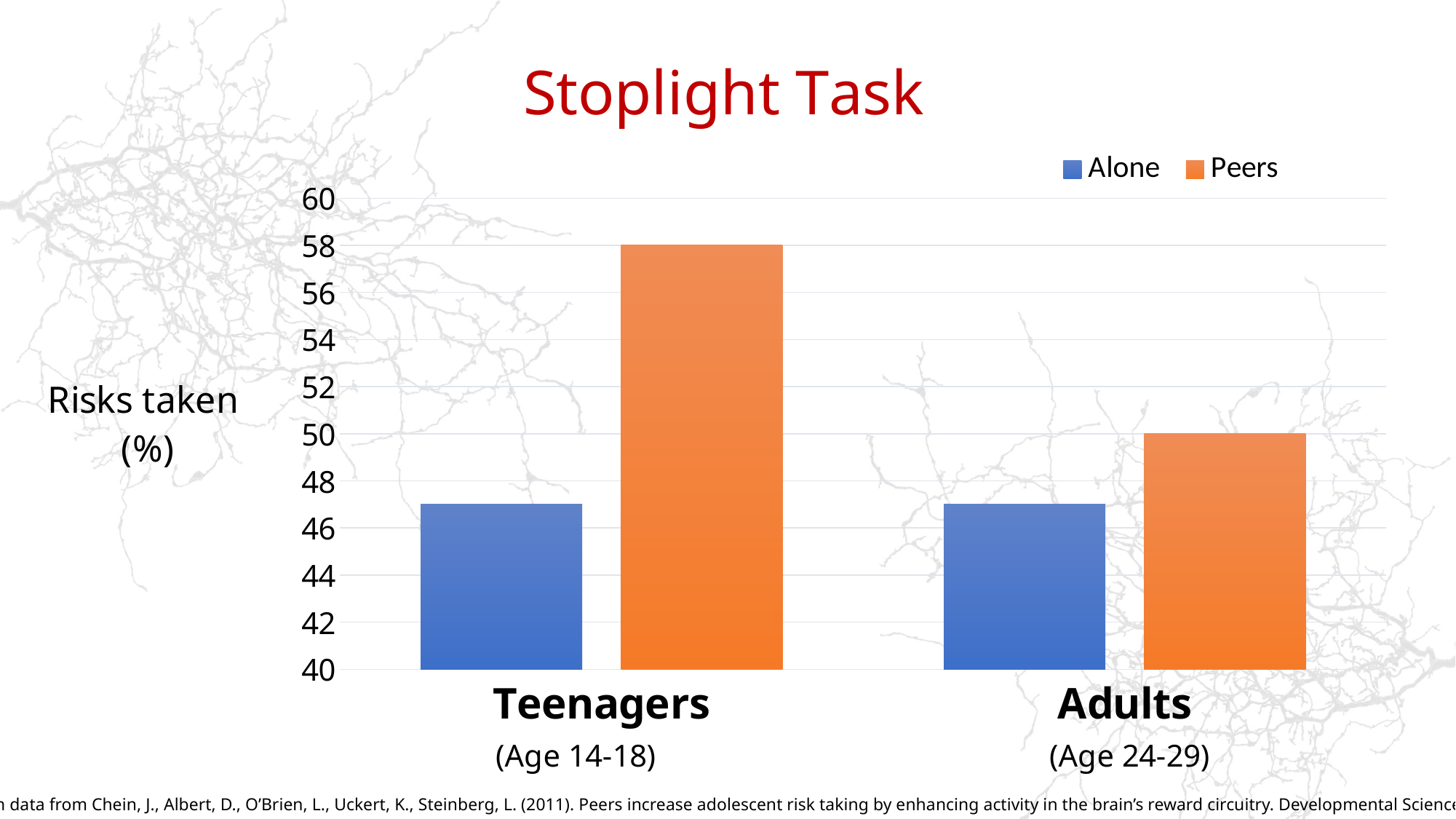
For Teenagers, which is larger: the Alone value or the Peers value? Peers Which group and condition has the highest bar on the chart? Teenagers, Peers How many age groups are shown on the x axis? 2 What kind of chart is shown on the slide? Bar chart Is the Alone value for Adults greater or less than 46? greater What is the difference between the Peers value for Teenagers and the Peers value for Adults? 8 What is the value for Peers in the Teenagers group? 58 Which group has the larger Peers value, Teenagers or Adults? Teenagers For Adults, which is larger: the Alone value or the Peers value? Peers What is the value for Peers in the Adults group? 50 How many series does the legend list? 2 Is the Alone value for Teenagers greater or less than 48? less